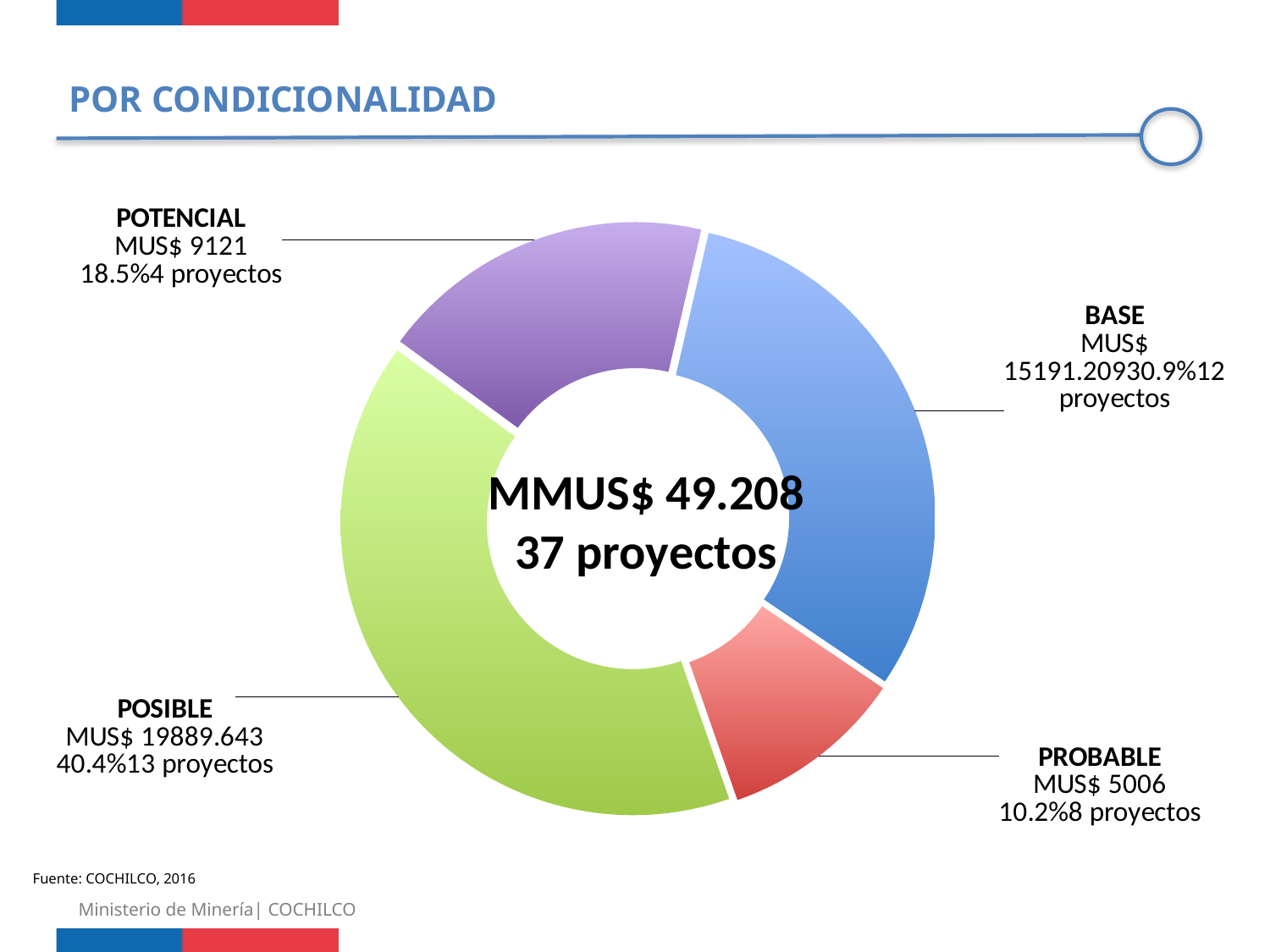
What is the value shown for PROBABLE? MUS$ 5006 What is the value shown for POSIBLE? MUS$ 19889.643 Which category has the largest share of the doughnut chart? POSIBLE What total number of projects is shown in the centre of the doughnut chart? 37 proyectos How many categories does the doughnut chart have? 4 What percentage share does POSIBLE have? 40.4% What is the value shown for POTENCIAL? MUS$ 9121 What kind of chart is shown on the slide? Doughnut (pie) chart Which has a larger share, POTENCIAL or BASE? BASE What percentage share does BASE have? 30.9% What is the title of the slide containing the chart? POR CONDICIONALIDAD Which category has the smallest share of the doughnut chart? PROBABLE